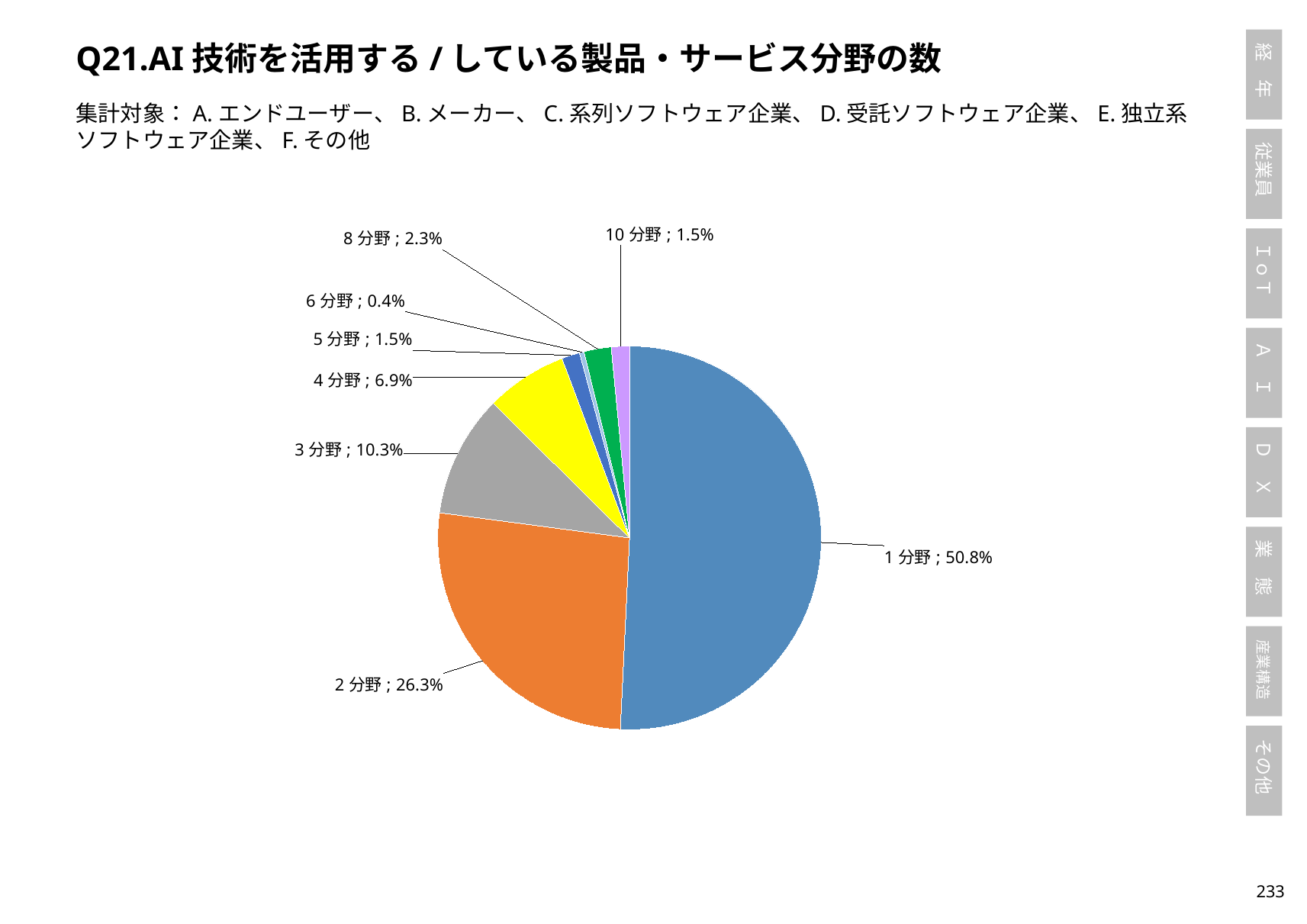
What percentage is shown for 8 分野? 2.3% What is the value shown for 4 分野? 6.9% How many slices does the pie chart have? 8 Which category has the smallest slice of the pie? 6 分野 Which is larger, the share for 3 分野 or the share for 4 分野? 3 分野 What is the difference in percentage points between 1 分野 and 2 分野? 24.5 What type of chart is shown on the slide? pie chart What share of the pie does 1 分野 account for? 50.8% What percentage is labelled for 3 分野? 10.3% Which category has the largest slice of the pie? 1 分野 What is the value shown for 2 分野? 26.3% What is the combined share of 5 分野 and 10 分野? 3.0%